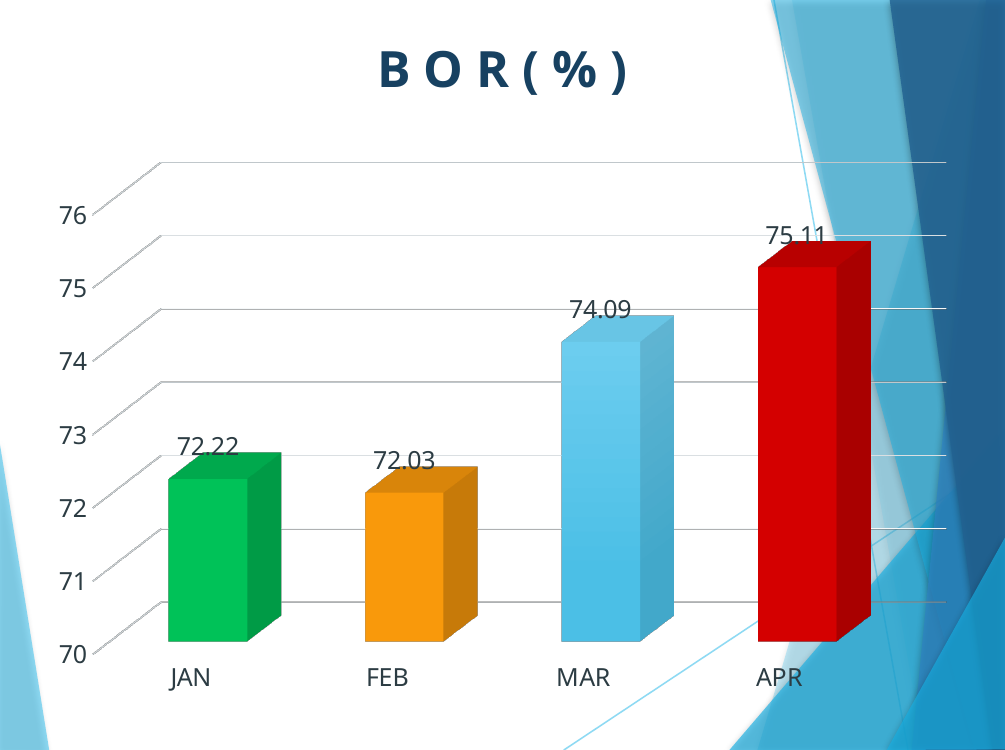
Which month has the lowest BOR (%)? FEB What is the difference between the BOR (%) values for APR and MAR? 1.02 How many months are shown on the chart? 4 What is the BOR (%) value for APR? 75.11 Is the BOR (%) value for APR greater or less than 75? greater What kind of chart is shown on the slide? bar chart What is the BOR (%) value for JAN? 72.22 What is the title of the chart? BOR(%) What is the difference between the BOR (%) values for JAN and FEB? 0.19 What is the BOR (%) value for MAR? 74.09 Which month has the highest BOR (%)? APR Which is larger, the BOR (%) value for MAR or for FEB? MAR